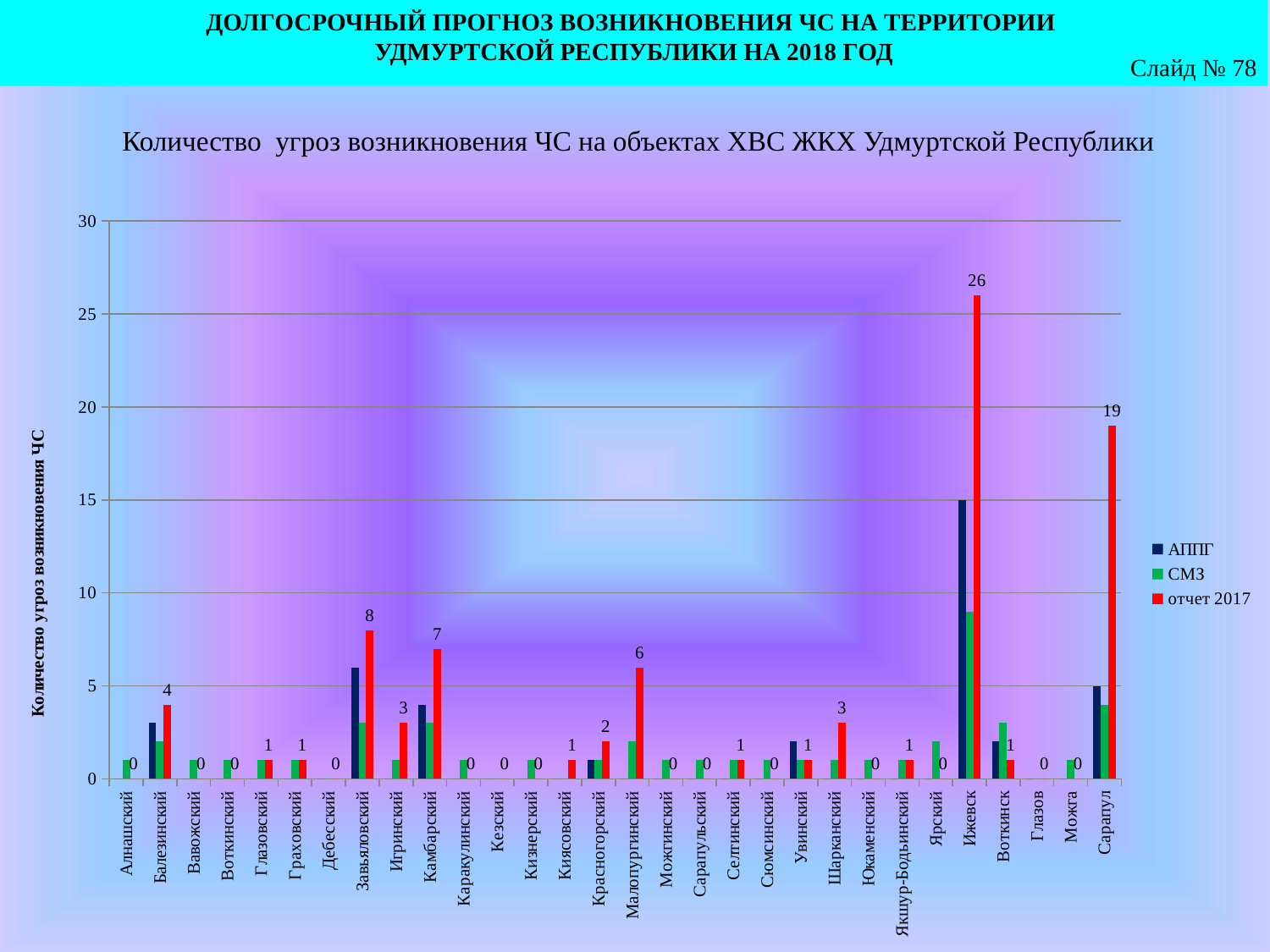
Which category has the highest value in the отчет 2017 series? Ижевск In the отчет 2017 series, which is larger: Завьяловский or Камбарский? Завьяловский Which series is shown in red in the legend? отчет 2017 What is the value of the отчет 2017 series for Ижевск? 26 What is the value of the отчет 2017 series for Малопургинский? 6 What kind of chart is shown on the slide? bar chart What is the value of the отчет 2017 series for Завьяловский? 8 What is the difference between the отчет 2017 values for Ижевск and Сарапул? 7 How many categories are shown on the x axis? 30 Is the АППГ value for Ижевск greater or less than 10? greater What is the value of the отчет 2017 series for Сарапул? 19 How many series does the legend list? 3